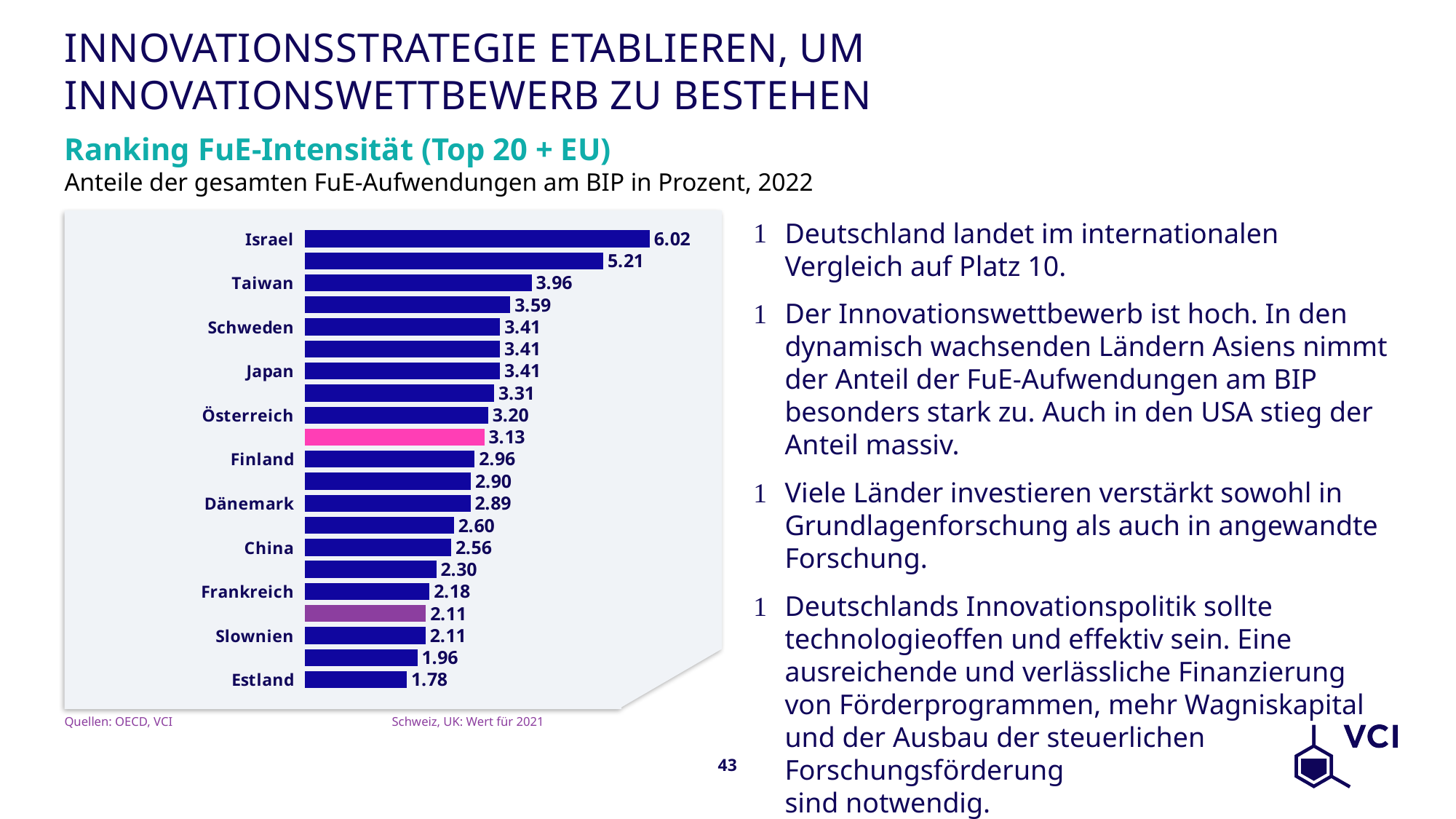
How many bars are shown in the chart? 21 Which country has the highest FuE-Intensität in the chart? Israel What is the difference between the values for Taiwan and Japan? 0.55 What is the value for Estland? 1.78 What is the difference between the values for Israel and Estland? 4.24 What is the value for Taiwan? 3.96 Which country has the lowest value in the chart? Estland Which has the larger value, Finland or Dänemark? Finland What is the value for Israel in the chart? 6.02 What is the value shown for China? 2.56 What value is labelled on the pink highlighted bar? 3.13 What kind of chart is shown on the slide? Bar chart